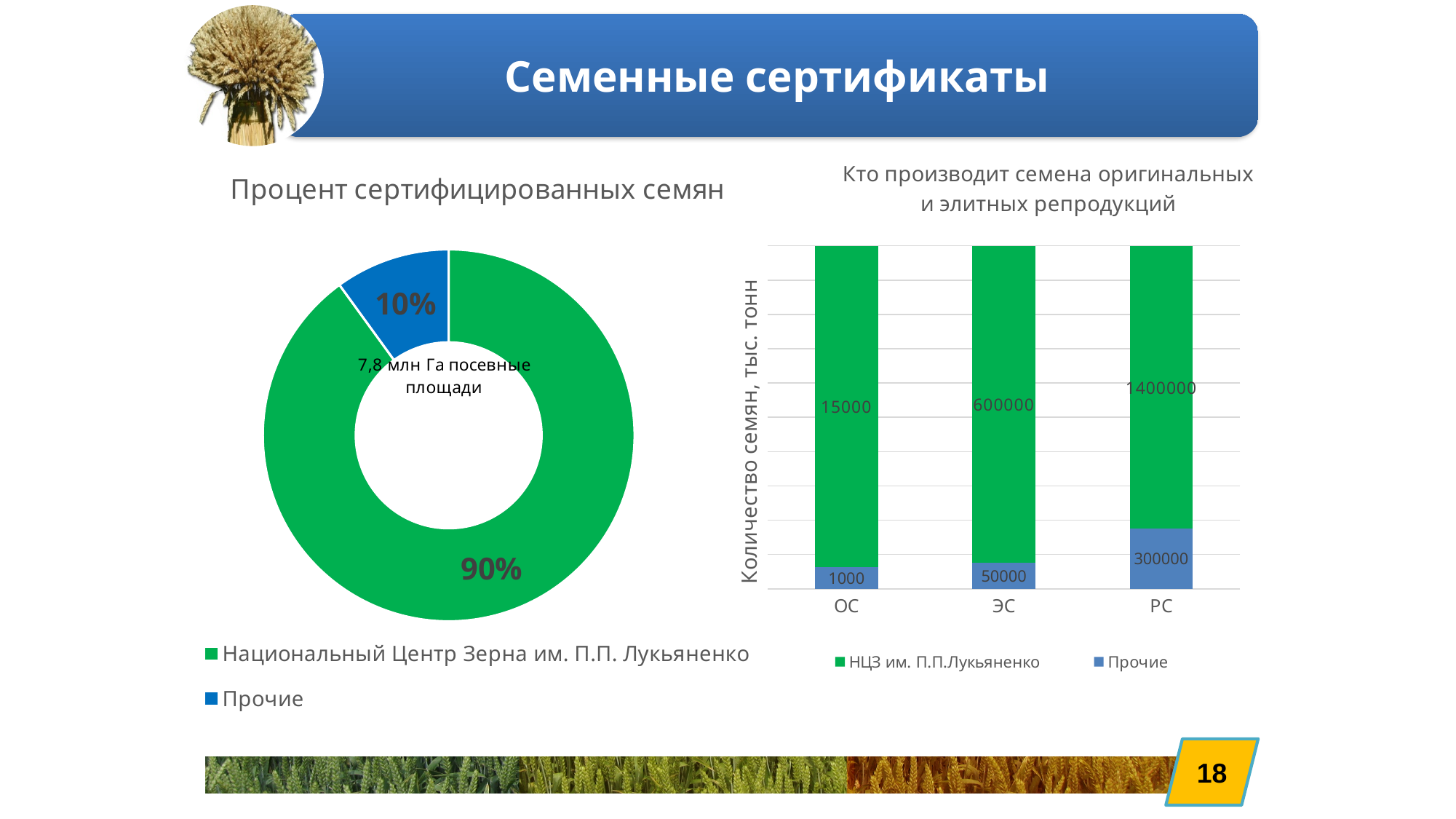
In the chart 'Кто производит семена оригинальных и элитных репродукций', what is the value for НЦЗ им. П.П.Лукьяненко in the ЭС category? 600000 In the chart 'Процент сертифицированных семян', what text is shown in the centre of the donut? 7,8 млн Га посевные площади In the chart 'Кто производит семена оригинальных и элитных репродукций', what is the difference between НЦЗ им. П.П.Лукьяненко and Прочие in the ЭС category? 550000 In the chart 'Кто производит семена оригинальных и элитных репродукций', how many series does the legend list? 2 What kind of chart is 'Процент сертифицированных семян'? Donut (pie) chart In the chart 'Кто производит семена оригинальных и элитных репродукций', what is the value for Прочие in the ОС category? 1000 In the chart 'Кто производит семена оригинальных и элитных репродукций', which category has the highest value for НЦЗ им. П.П.Лукьяненко? РС In the chart 'Процент сертифицированных семян', what share is labelled for Национальный Центр Зерна им. П.П. Лукьяненко? 90% In the chart 'Процент сертифицированных семян', what share is labelled for Прочие? 10% In the chart 'Кто производит семена оригинальных и элитных репродукций', how many categories are shown on the x axis? 3 In the chart 'Кто производит семена оригинальных и элитных репродукций', what is the value for Прочие in the РС category? 300000 In the chart 'Кто производит семена оригинальных и элитных репродукций', what is the total of the two series for the РС bar? 1700000